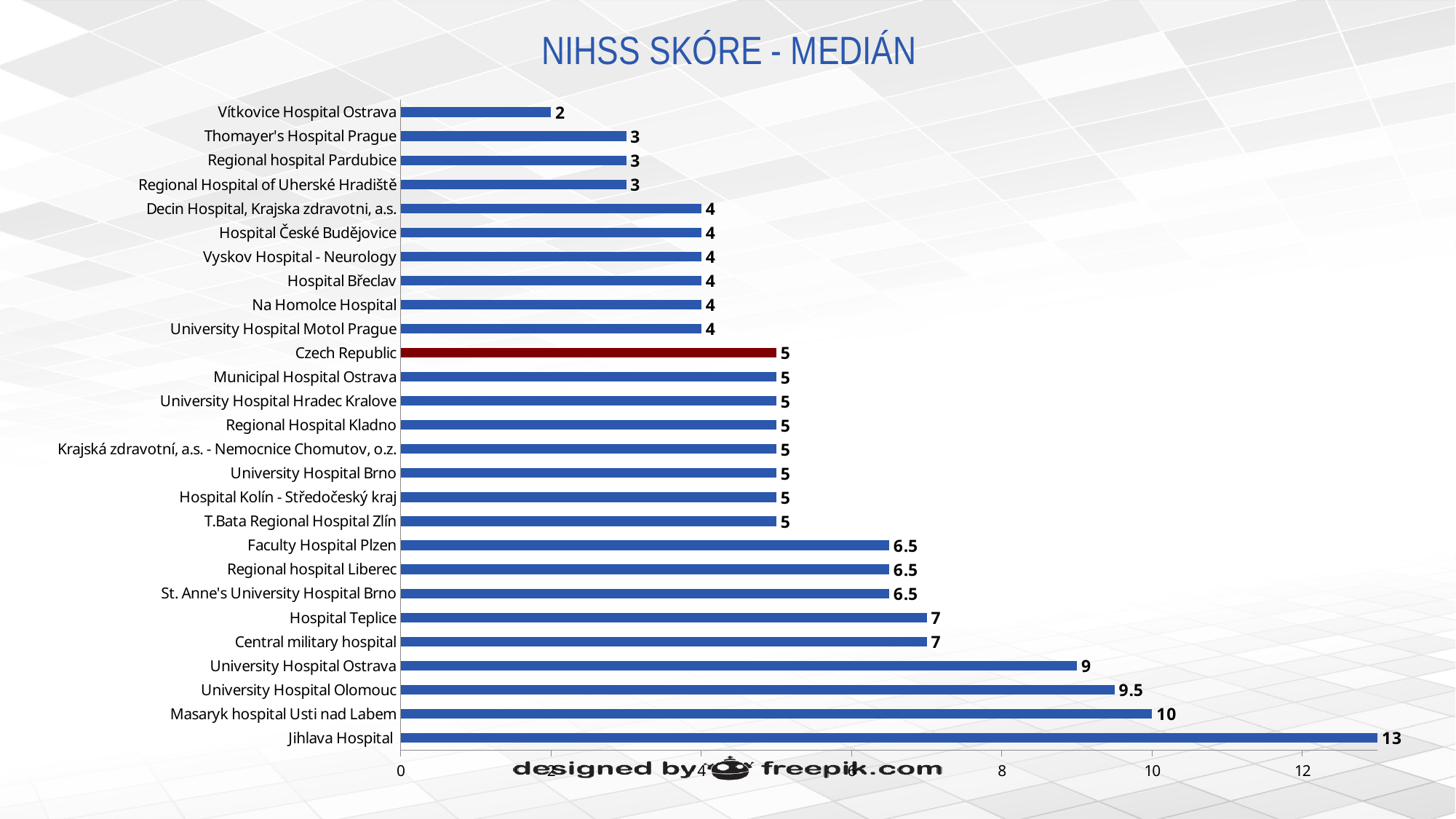
What is the NIHSS median score for Jihlava Hospital? 13 Which hospital has the lowest NIHSS median score? Vítkovice Hospital Ostrava Which has a larger value, University Hospital Ostrava or Hospital Teplice? University Hospital Ostrava What is the difference between the values for Jihlava Hospital and Masaryk hospital Usti nad Labem? 3 How many categories (bars) are shown in the chart? 27 What kind of chart is shown on the slide? Bar chart What is the value shown for Czech Republic? 5 What is the title of the chart? NIHSS SKÓRE - MEDIÁN Is the value for Masaryk hospital Usti nad Labem greater or less than 8? greater What is the value for Faculty Hospital Plzen? 6.5 Which hospital has the highest NIHSS median score? Jihlava Hospital What is the value for University Hospital Olomouc? 9.5